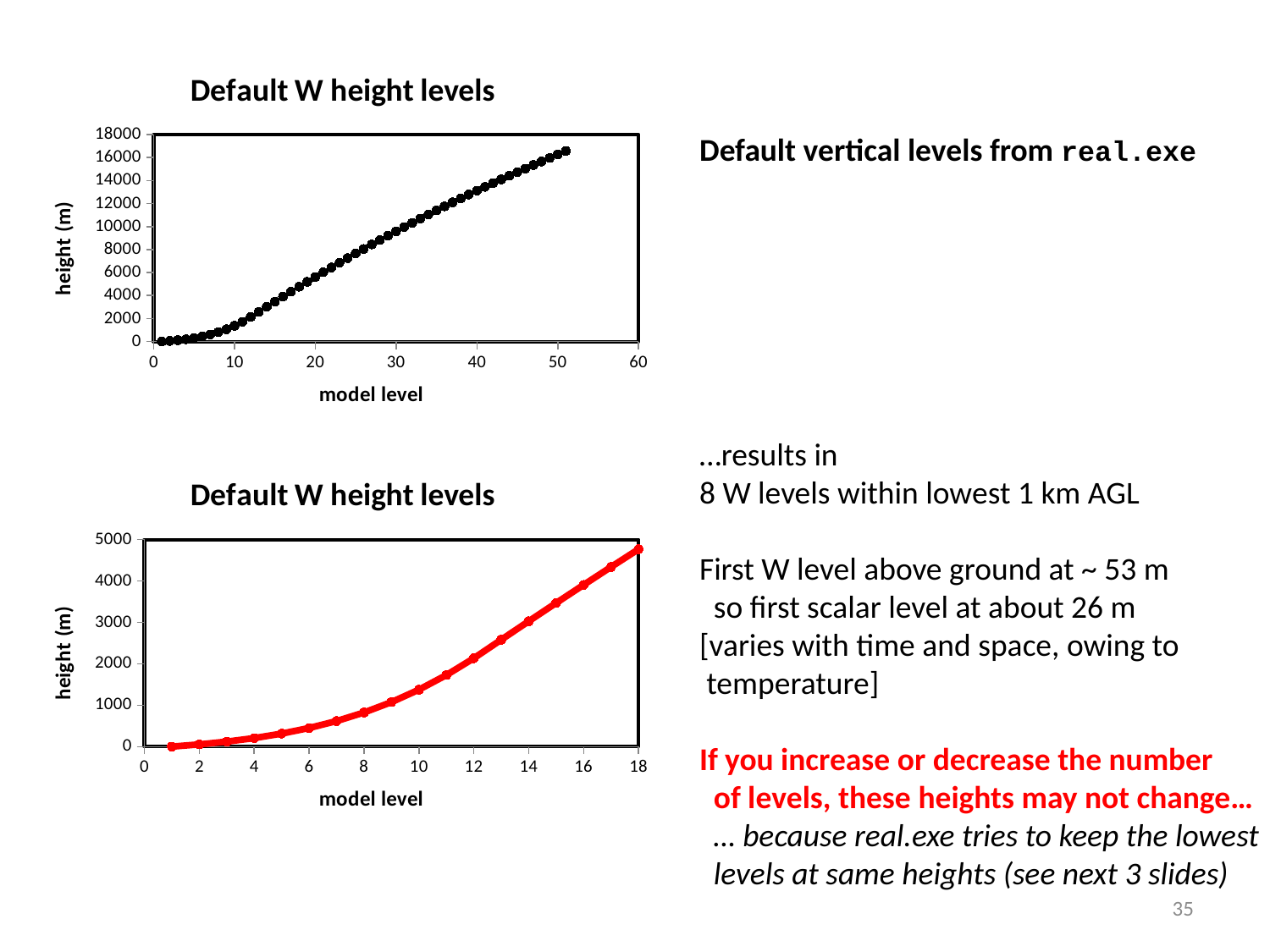
In the top chart, does height rise or fall as model level increases? rise In the top chart, which has the greater height: model level 40 or model level 20? model level 40 What is the title of the top chart? Default W height levels In the bottom chart, is the height at model level 10 greater or less than 1000? greater In the bottom chart, is the height at model level 6 greater or less than 1000? less In the top chart, is the height at model level 30 greater or less than 8000? greater In the bottom chart, does height rise or fall as model level increases? rise What kind of chart is the top chart on the slide? scatter/line chart What is the y-axis label of the bottom chart? height (m)